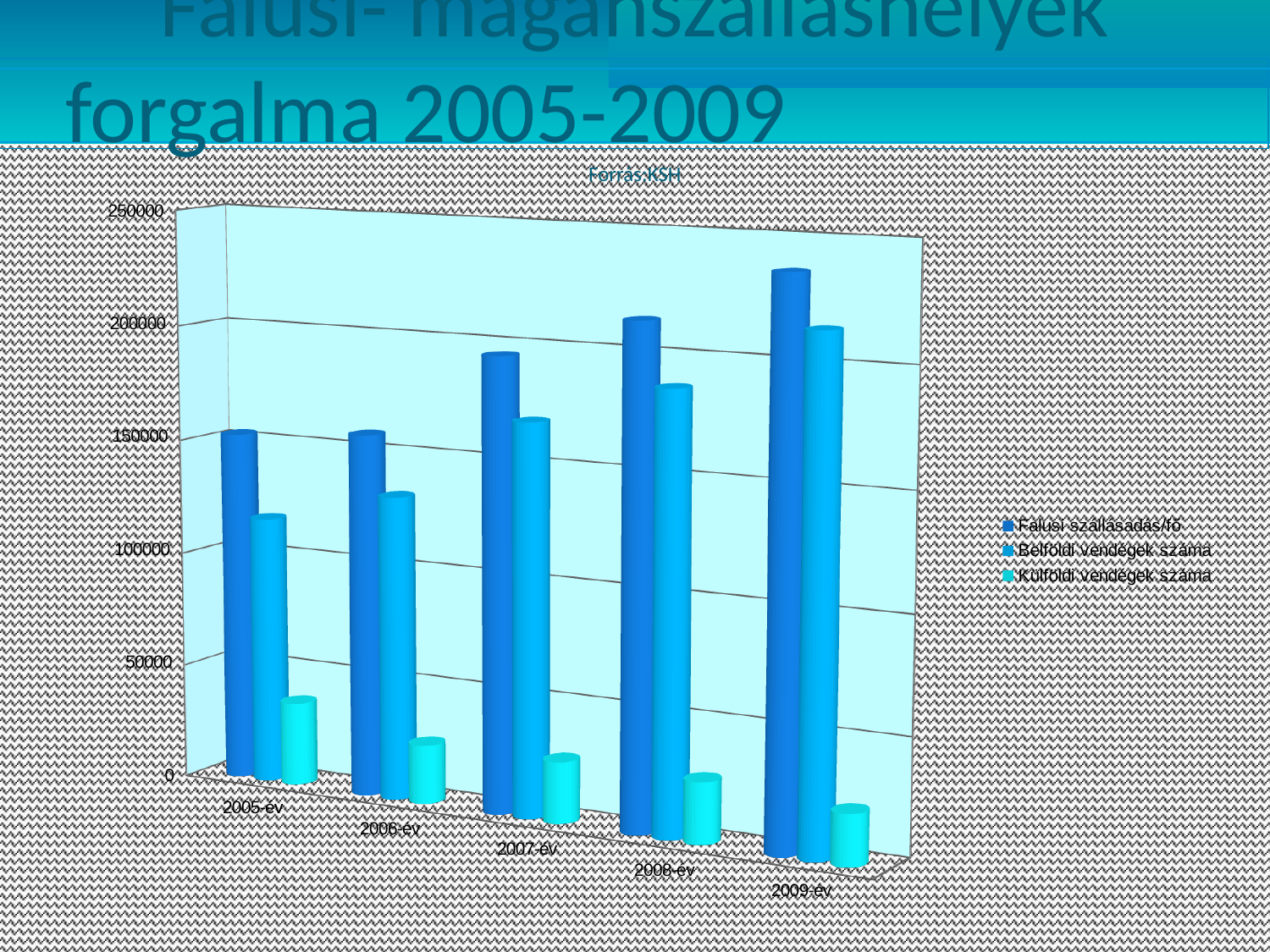
Is the value for Belföldi vendégek száma in 2005.év greater or less than 150000? less In which year is the value for Falusi szállásadás/fő highest? 2009-év What kind of chart is shown on the slide? bar chart Which is larger in 2005.év: Falusi szállásadás/fő or Belföldi vendégek száma? Falusi szállásadás/fő What is the title printed above the chart? Forrás:KSH How many year categories are shown on the x axis? 5 Do the values for Falusi szállásadás/fő rise or fall from 2005.év to 2009.év? rise Which series is listed first in the legend? Falusi szállásadás/fő Is the value for Külföldi vendégek száma in 2009.év greater or less than 50000? less In which year is the value for Belföldi vendégek száma lowest? 2005-év How many series does the legend list? 3 Is the value for Falusi szállásadás/fő in 2009.év greater or less than 200000? greater